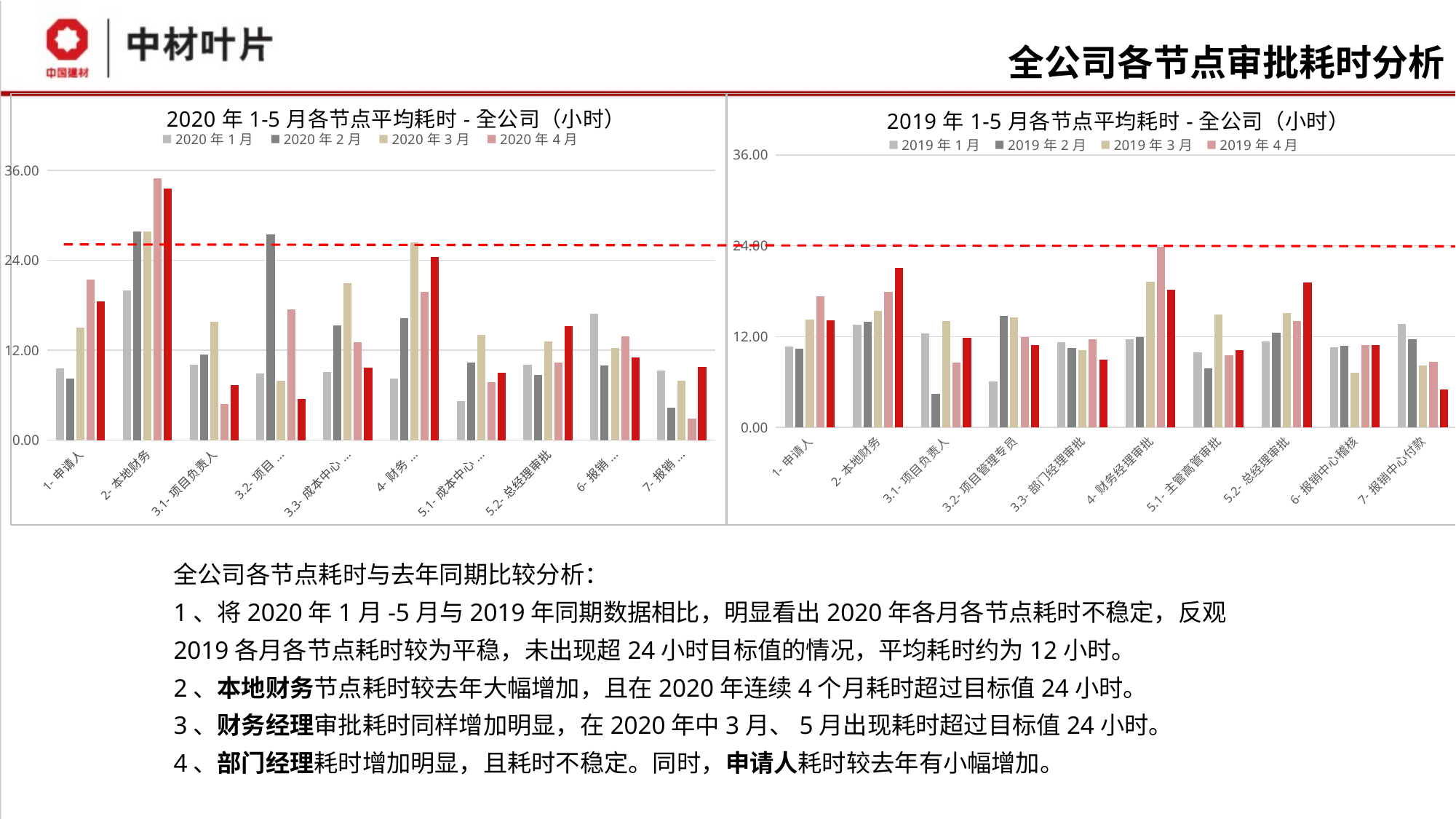
In the right chart (2019年1-5月各节点平均耗时), is the 2019年1月 value for 3.2-项目管理专员 greater or less than 12.00? less What kind of chart is the left chart titled 2020年1-5月各节点平均耗时-全公司（小时）? bar chart How many categories are shown on the x axis of the right chart (2019年1-5月各节点平均耗时)? 10 In the left chart (2020年1-5月各节点平均耗时), which category has the tallest bar? 2-本地财务 In the right chart (2019年1-5月各节点平均耗时), which is larger for 2019年4月: 3.1-项目负责人 or 2-本地财务? 2-本地财务 What is the title of the right chart on the slide? 2019年1-5月各节点平均耗时-全公司（小时） How many series does the legend of the right chart (2019年1-5月各节点平均耗时) list? 4 In the left chart (2020年1-5月各节点平均耗时), which is larger for 2020年4月: 1-申请人 or 2-本地财务? 2-本地财务 In the left chart (2020年1-5月各节点平均耗时), is the 2020年4月 value for 2-本地财务 greater or less than 24.00? greater In the right chart (2019年1-5月各节点平均耗时), is the 2019年2月 value for 3.1-项目负责人 greater or less than 12.00? less